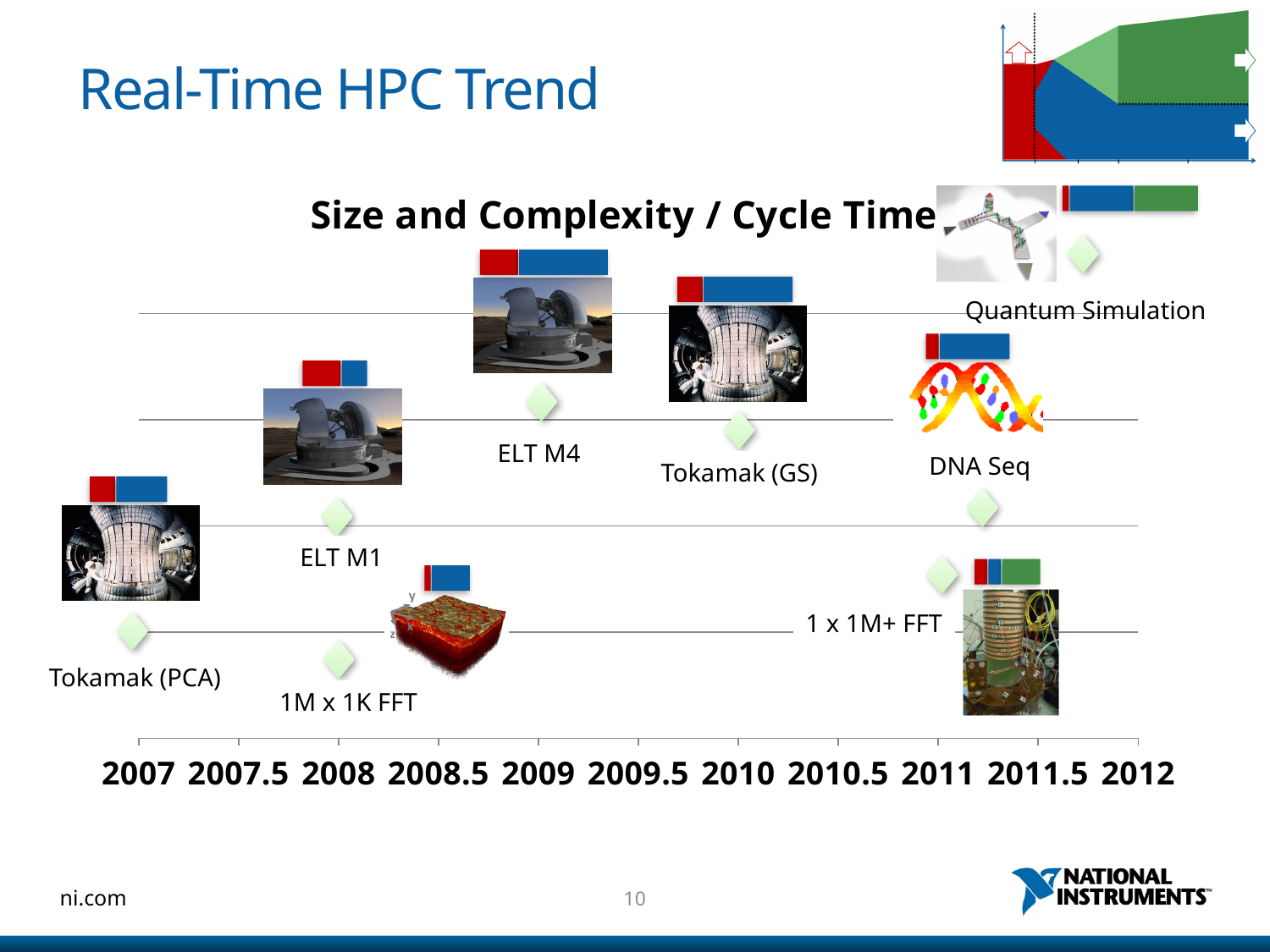
Which data point is plotted highest on the chart? Quantum Simulation Do the plotted points generally rise or fall as the years increase along the x axis? rise What is the last year label on the x axis? 2012 Which is plotted higher on the chart, ELT M4 or ELT M1? ELT M4 Which data point is plotted latest on the x axis? Quantum Simulation What is the first year label on the x axis? 2007 Which is plotted higher on the chart, Tokamak (GS) or Tokamak (PCA)? Tokamak (GS) What is the title of the chart? Size and Complexity / Cycle Time How many labeled data points are plotted on the chart? 8 Which data point is plotted earliest on the x axis? Tokamak (PCA) What kind of chart is shown on the slide? scatter chart How many tick labels are shown on the x axis? 11